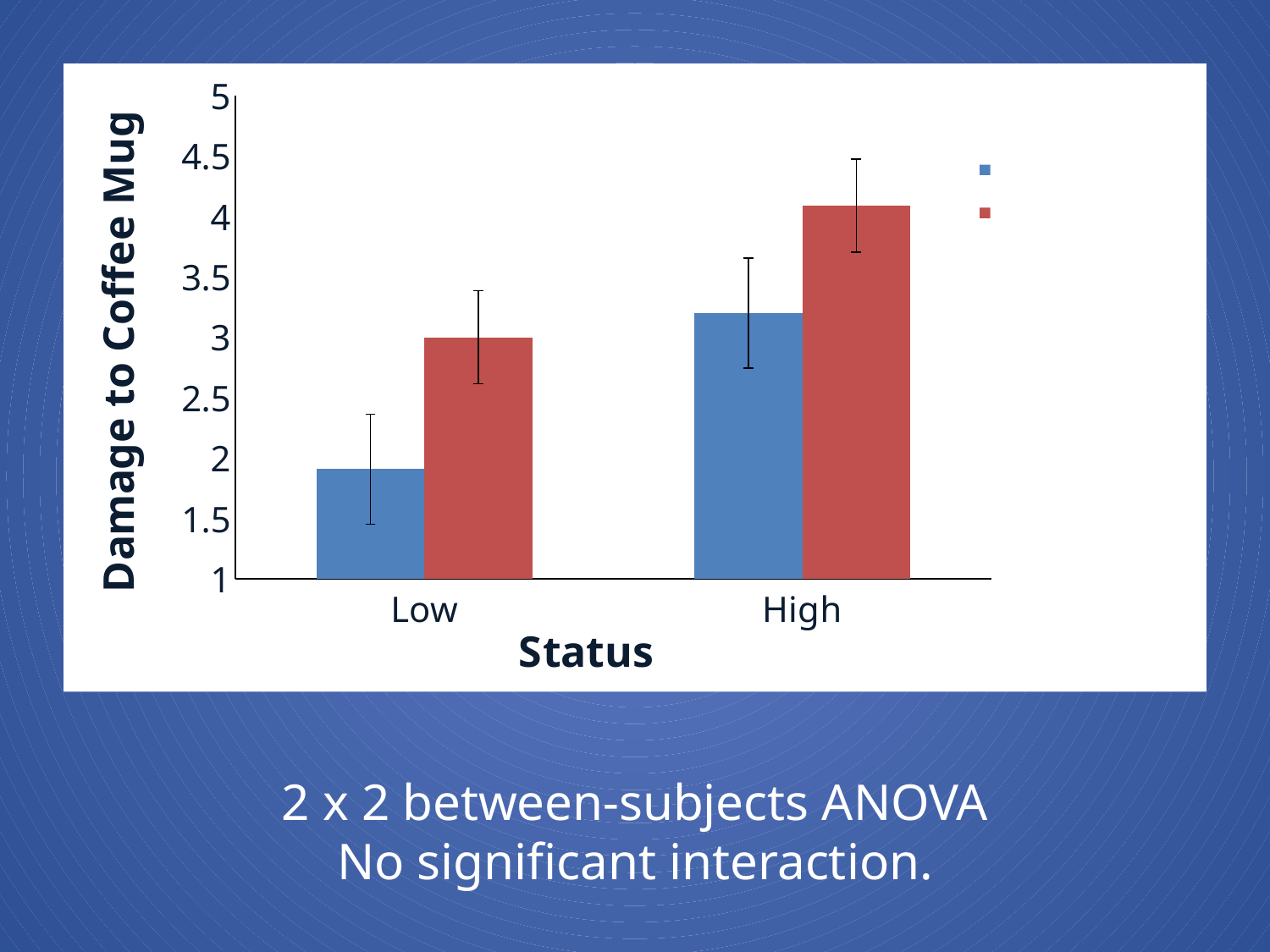
What is the title of the y axis of the chart? Damage to Coffee Mug Is the value of the red bar for Low greater or less than 3.5? less Is the value of the blue bar for Low greater or less than 2.5? less For the blue series, is the value for High larger or smaller than the value for Low? larger What kind of chart is shown on the slide? bar chart How many series does the chart's legend list? 2 What is the title of the x axis of the chart? Status Which bar is the shortest in the chart? the blue bar for Low Is the value of the blue bar for High greater or less than 3? greater Which bar is the tallest in the chart? the red bar for High How many categories are shown on the x axis of the chart? 2